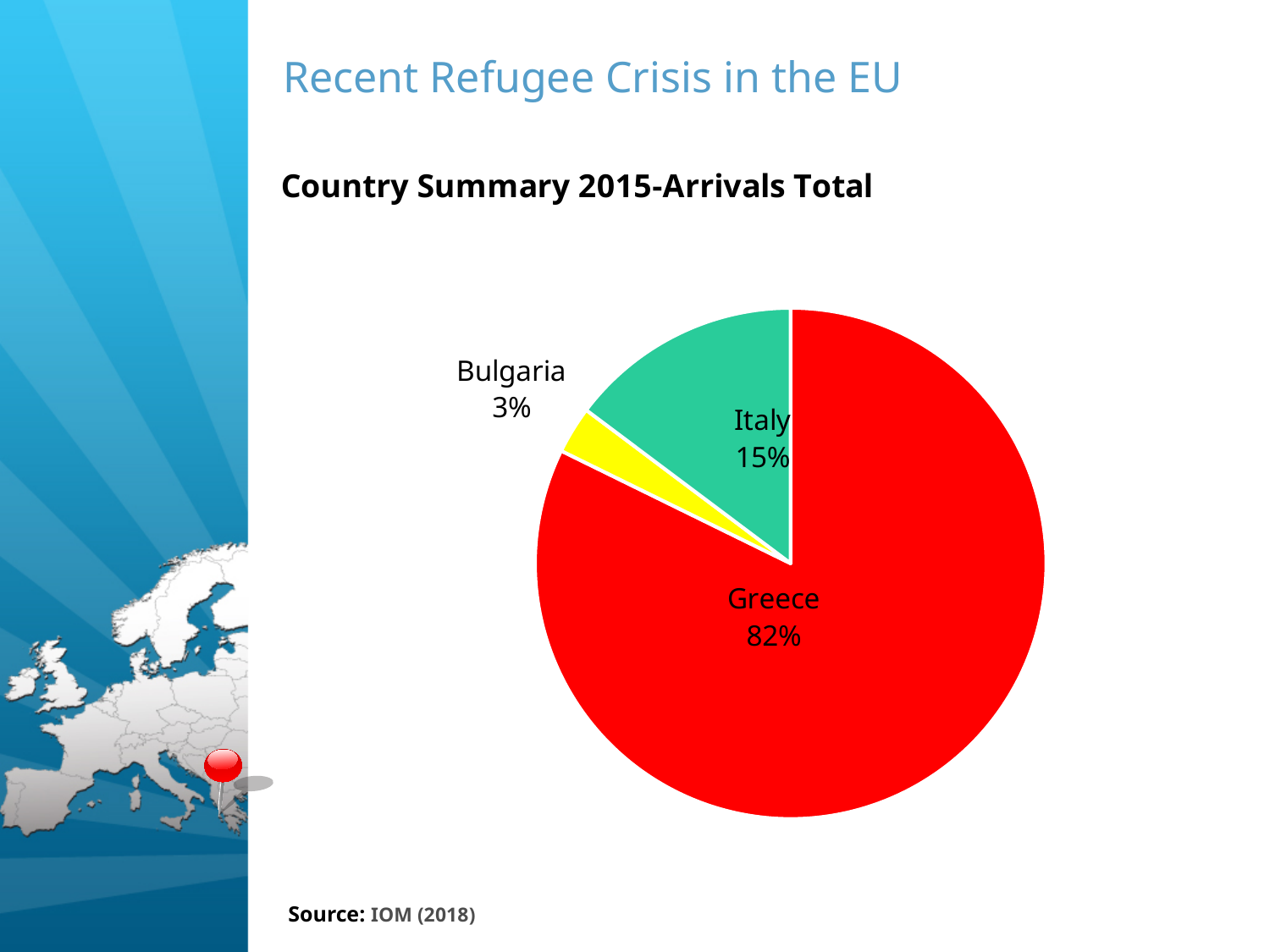
How many countries are shown in the pie chart? 3 What share of 2015 arrivals does Bulgaria account for? 3% What share of 2015 arrivals does Greece account for? 82% What is the difference in percentage points between Italy's share and Bulgaria's share? 12 What share of 2015 arrivals does Italy account for? 15% Which has a larger share of arrivals, Italy or Bulgaria? Italy Which country has the largest share of arrivals in the pie chart? Greece What is the difference in percentage points between Greece's share and Italy's share? 67 Which country has the smallest share of arrivals in the pie chart? Bulgaria What kind of chart is shown on the slide? Pie chart What colour is the slice for Italy? Green What is the title of the chart? Country Summary 2015-Arrivals Total